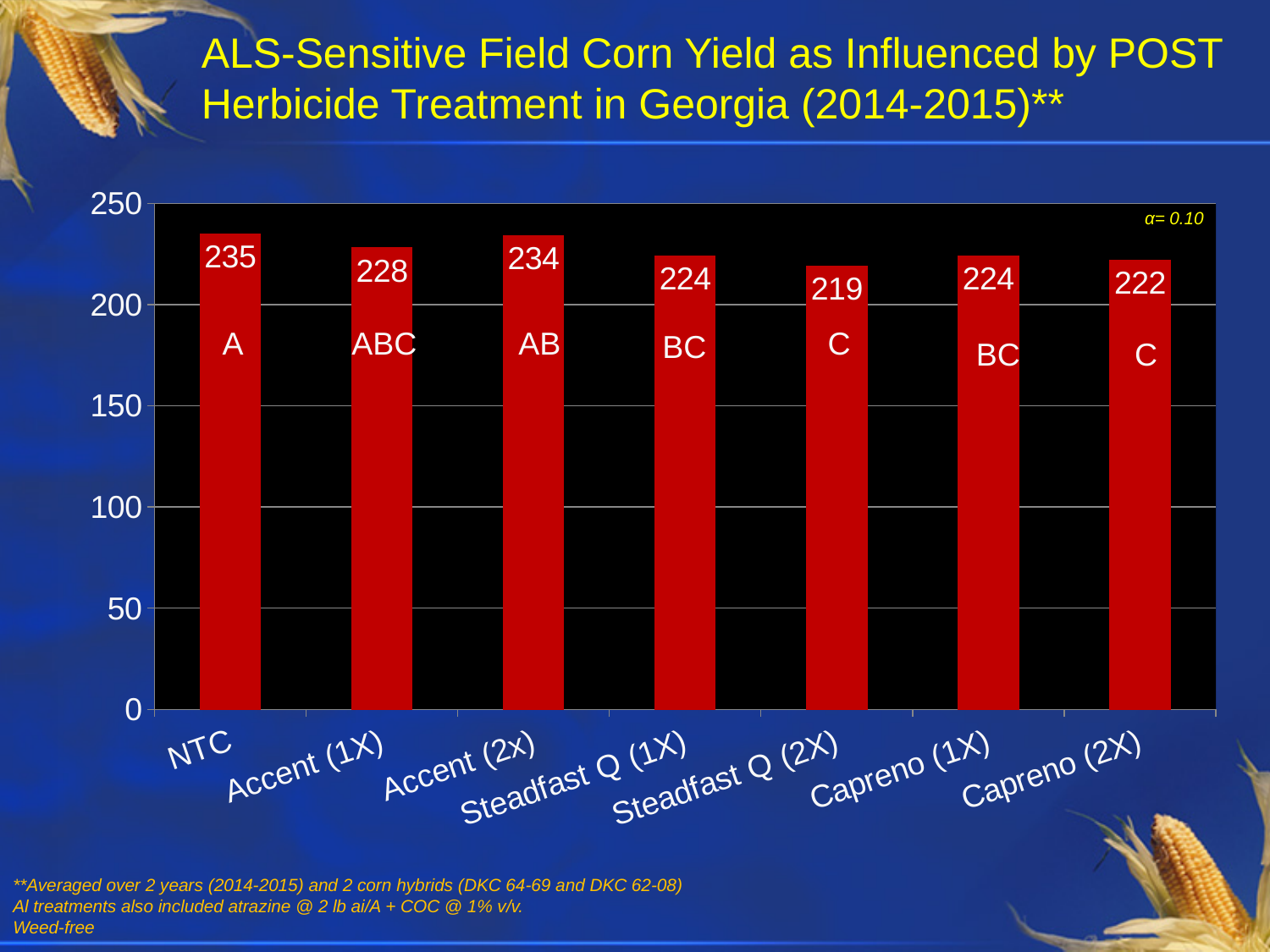
What is the yield value for NTC? 235 What kind of chart is shown on the slide? Bar chart What is the difference in yield between NTC and Steadfast Q (2X)? 16 What statistical letter grouping is shown on the NTC bar? A Is the value for Capreno (2X) greater or less than 200? greater What is the yield value for Steadfast Q (2X)? 219 What is the yield value for Accent (1X)? 228 Which treatment has the lowest yield? Steadfast Q (2X) Which has a higher yield, Accent (1X) or Capreno (1X)? Accent (1X) Which treatment has the highest yield? NTC How many treatments are shown on the chart? 7 What is the difference in yield between Accent (2x) and Capreno (2X)? 12